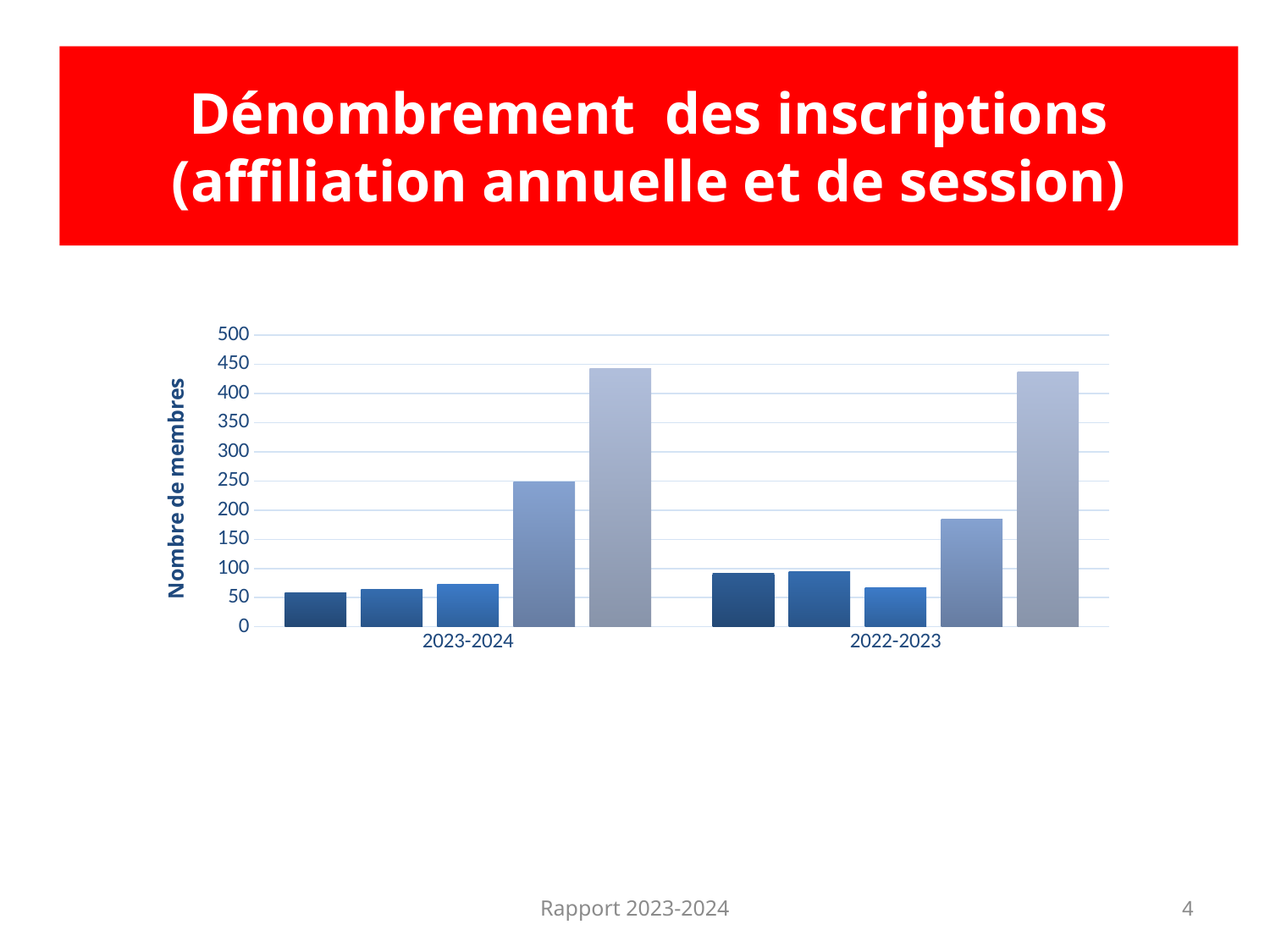
Within the 2023-2024 group, which bar is the lowest? the first bar Is the value of the fifth (tallest) bar in the 2023-2024 group greater or less than 400? greater Is the value of the fourth bar in the 2022-2023 group greater or less than 150? greater How many categories are shown on the x axis of the chart? 2 What is the title of the vertical axis of the chart? Nombre de membres Is the value of the first bar in the 2023-2024 group greater or less than 100? less Which is larger: the fourth bar in the 2023-2024 group or the fourth bar in the 2022-2023 group? 2023-2024 Within the 2022-2023 group, which bar is the lowest? the third bar Which is larger: the first bar in the 2023-2024 group or the first bar in the 2022-2023 group? 2022-2023 How many bars are plotted for the 2023-2024 category? 5 What kind of chart is shown on the slide? bar chart